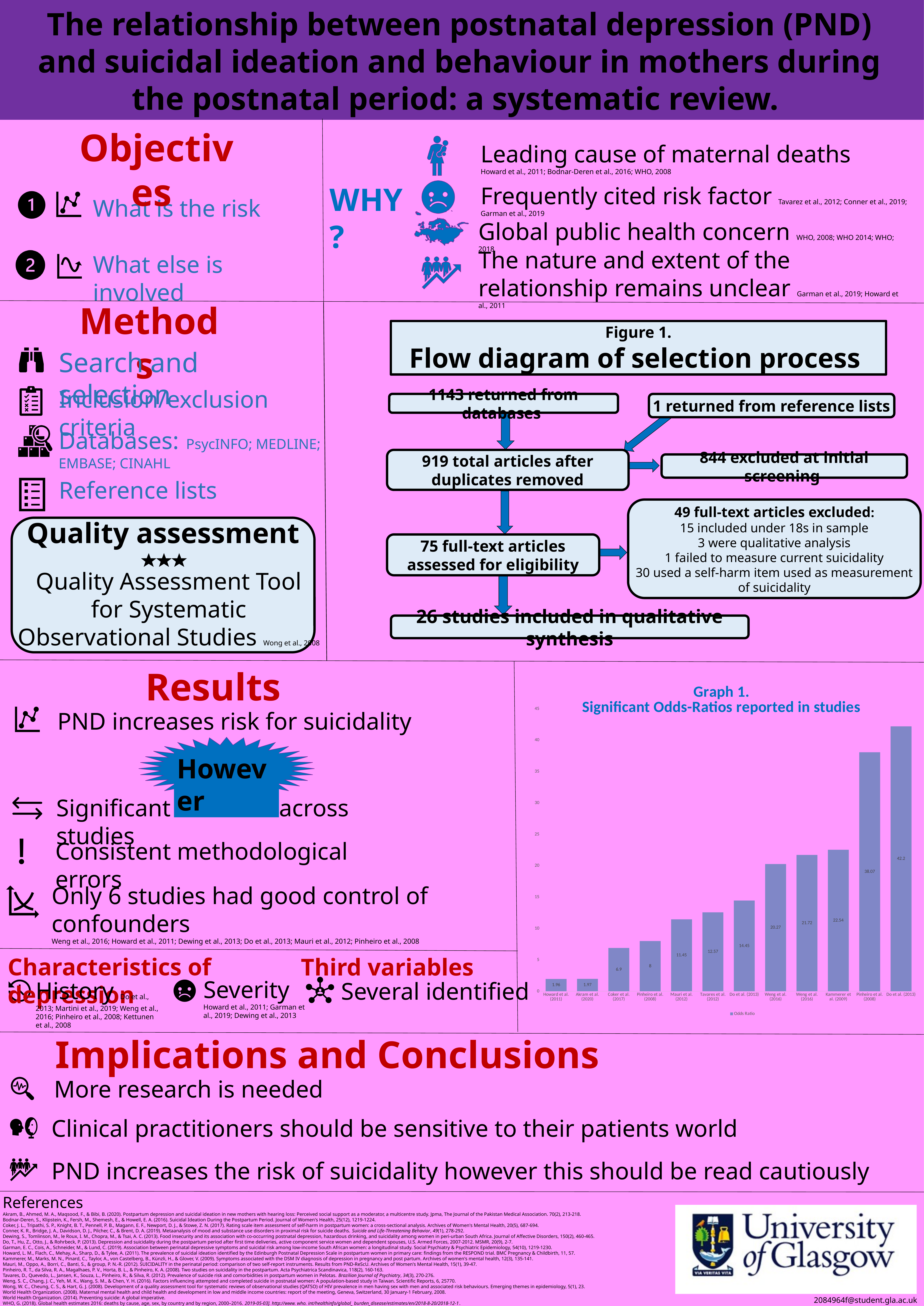
What type of chart is Graph 1? bar chart Do the values in Graph 1 rise or fall from left to right along the x axis? rise How many series does the legend of Graph 1 list? 1 In Graph 1, what is the difference between the odds ratios for Tavares et al. (2012) and Mauri et al. (2012)? 1.12 In Graph 1, which study has the lowest odds ratio? Howard et al. (2011) In Graph 1, which has a larger odds ratio, Kammerer et al. (2009) or Coker et al. (2017)? Kammerer et al. (2009) In Graph 1, what is the value of the rightmost (tallest) bar? 42.2 In Graph 1, what is the odds ratio reported for Coker et al. (2017)? 6.9 In Graph 1, what is the odds ratio reported for Kammerer et al. (2009)? 22.54 In Graph 1, what is the odds ratio reported for Mauri et al. (2012)? 11.45 In Graph 1, what is the odds ratio reported for Howard et al. (2011)? 1.96 In Graph 1, how many bars (studies) are plotted? 12